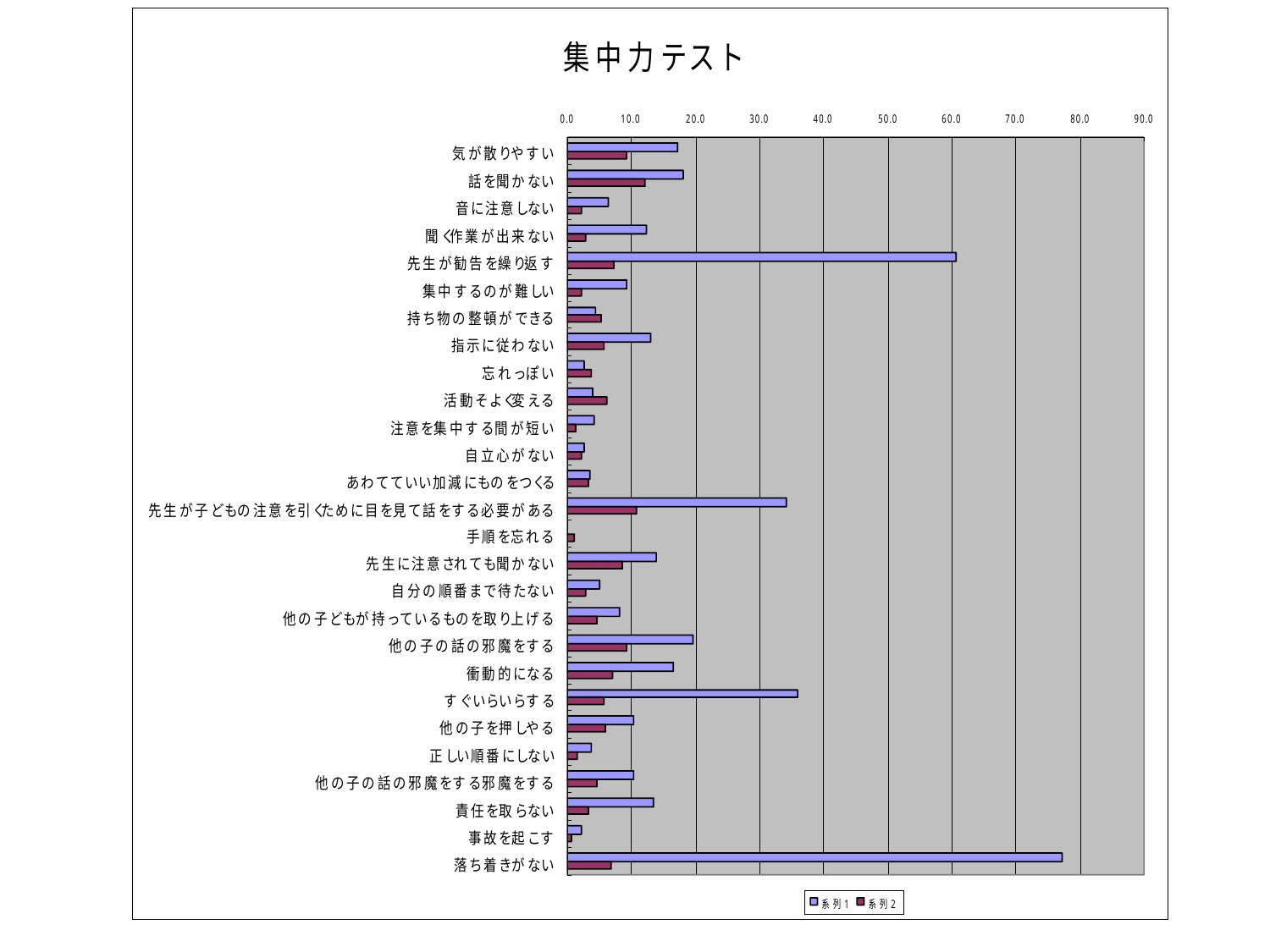
What are the names of the series in the legend? 系列1 and 系列2 Is the 系列1 value for 気が散りやすい greater or less than 20? less Which has the larger 系列1 value: 落ち着きがない or 先生が勧告を繰り返す? 落ち着きがない Is the 系列1 value for 先生が勧告を繰り返す greater or less than 50? greater How many series does the legend list? 2 How many categories are plotted on the chart? 27 What kind of chart is shown on the slide? bar chart Is the 系列1 value for 落ち着きがない greater or less than 70? greater Which has the larger 系列2 value: 話を聞かない or 音に注意しない? 話を聞かない Which category has the highest value for 系列1? 落ち着きがない What is the title of the chart? 集中力テスト